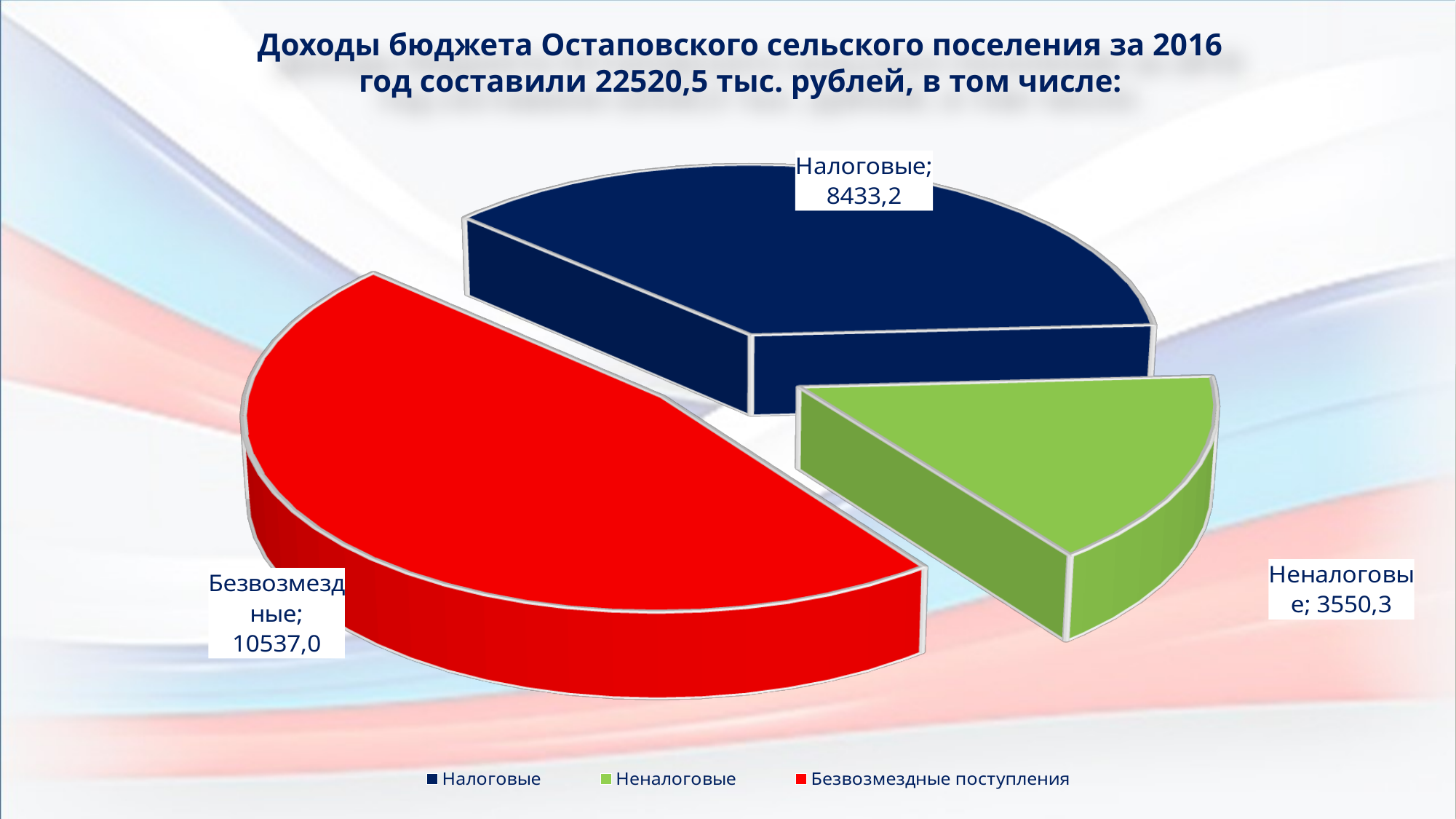
What is the value of the Неналоговые slice? 3550,3 What is the value of the Налоговые slice? 8433,2 Which is larger, Налоговые or Неналоговые? Налоговые What colour is the Безвозмездные поступления slice? Red What is the difference between the Налоговые and Неналоговые values? 4882,9 What type of chart is shown on the slide? Pie chart What is the total of all three slices, as stated in the slide title? 22520,5 тыс. рублей What is the value of the Безвозмездные slice? 10537,0 What is the difference between the Безвозмездные and Налоговые values? 2103,8 How many slices does the pie chart have? 3 Which category has the largest slice of the pie? Безвозмездные Which category has the smallest slice of the pie? Неналоговые